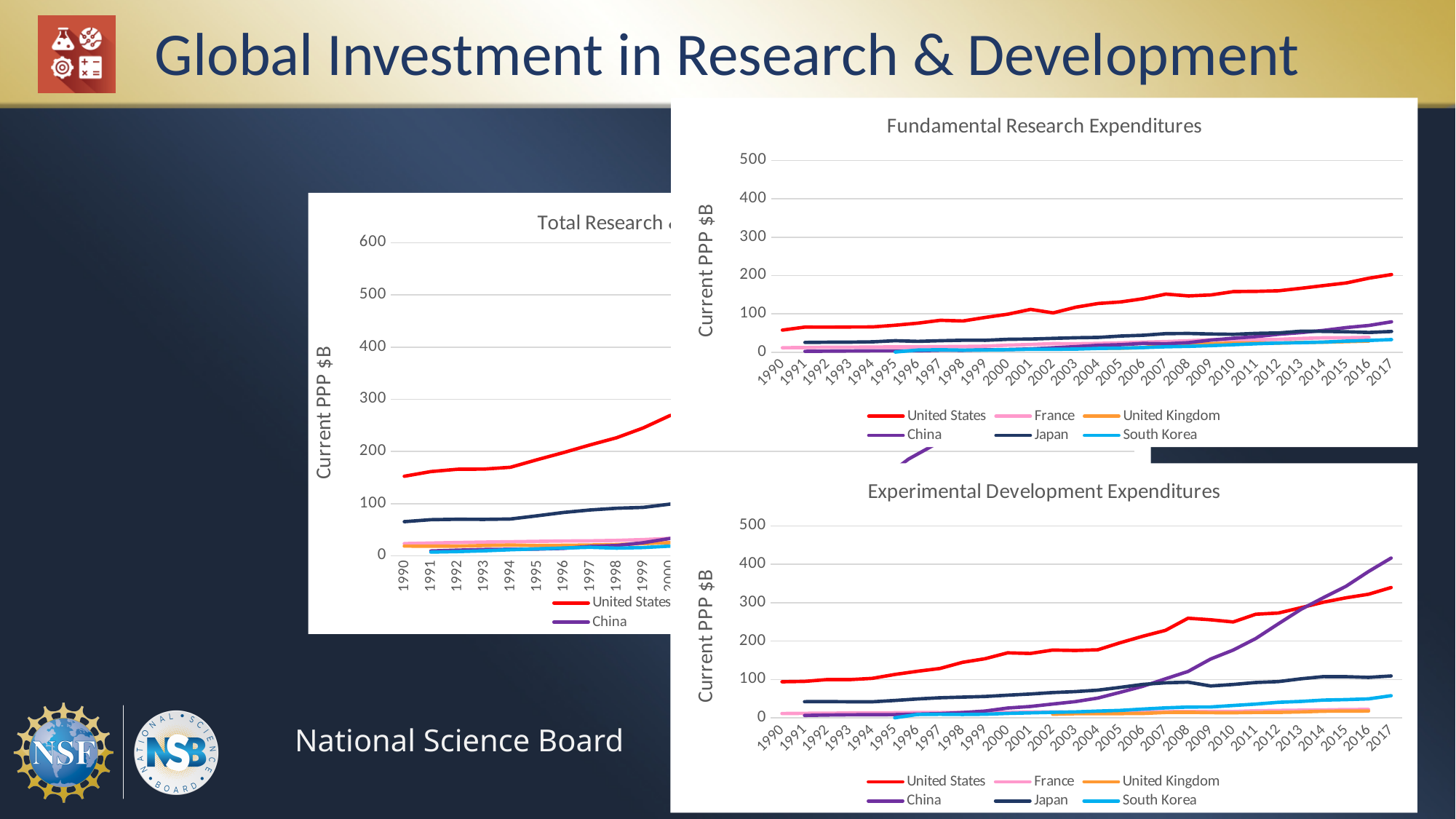
How many years are shown on the x axis of the Experimental Development Expenditures chart? 28 In the Fundamental Research Expenditures chart, does the United States line rise or fall from 1990 to 2017? rise In the Fundamental Research Expenditures chart, is the value for the United States in 2017 greater or less than 100? greater In the Experimental Development Expenditures chart, which country has the highest value in 2017? China In the Experimental Development Expenditures chart, is the value for the United States in 2017 greater or less than 400? less In the Experimental Development Expenditures chart, is the value for China in 2017 greater or less than 300? greater What is the y-axis label of the Fundamental Research Expenditures chart? Current PPP $B What kind of chart is the Fundamental Research Expenditures chart? line chart How many series does the legend of the Experimental Development Expenditures chart list? 6 In the Fundamental Research Expenditures chart, which country has the highest value in 2017? United States In the Experimental Development Expenditures chart, which is larger in 2017, China or the United States? China